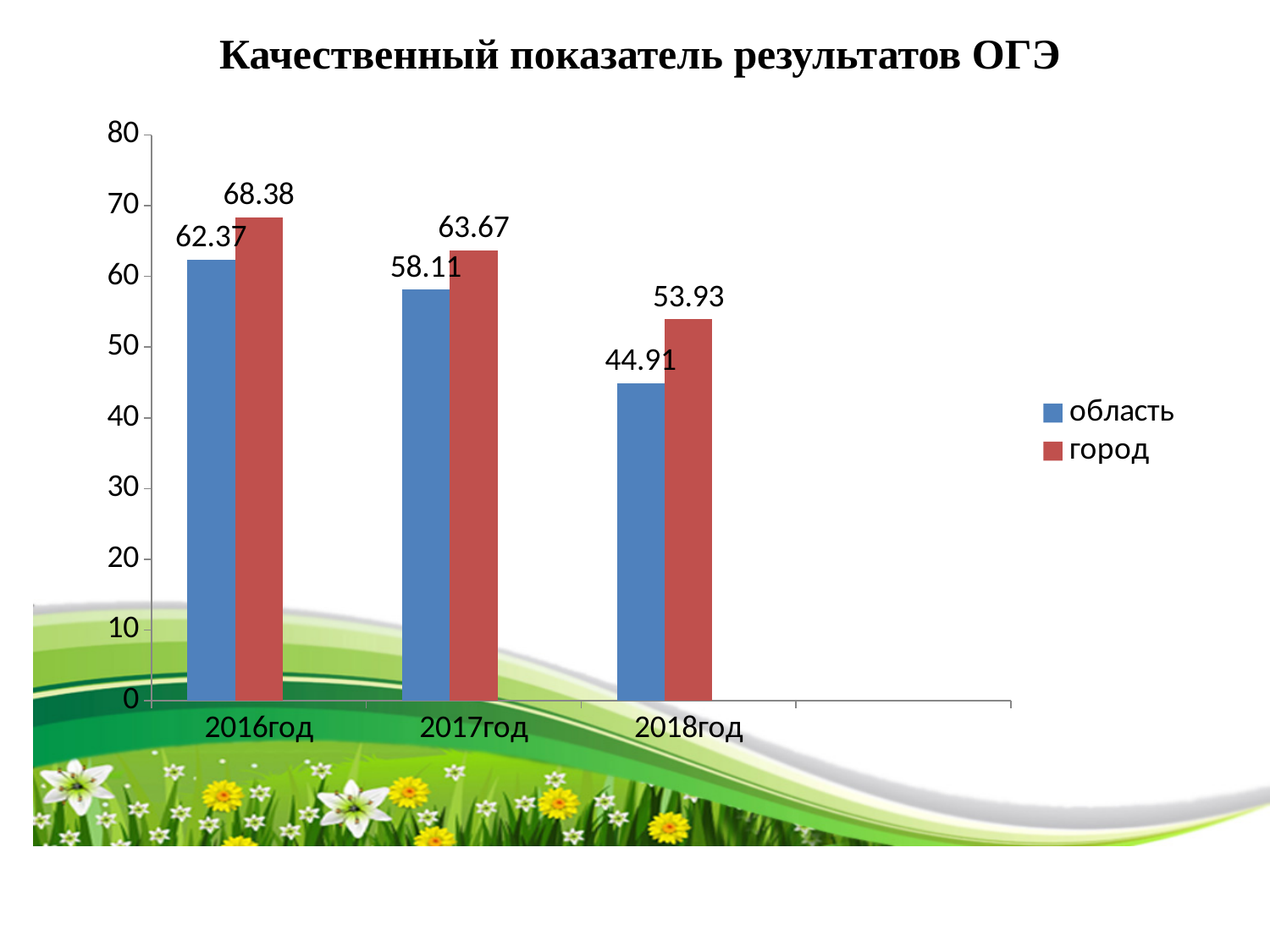
What is the difference between город and область in 2018год? 9.02 What kind of chart is shown? bar chart What is the value for город in 2018год? 53.93 Which year has the highest value for город? 2016год Do the values for область rise or fall from 2016год to 2018год? fall How many years are shown on the x axis? 3 Which year has the lowest value for область? 2018год Which is larger in 2017год, область or город? город What is the value for город in 2017год? 63.67 What is the value for область in 2016год? 62.37 Is the value for область in 2018год greater or less than 50? less How many series does the legend list? 2